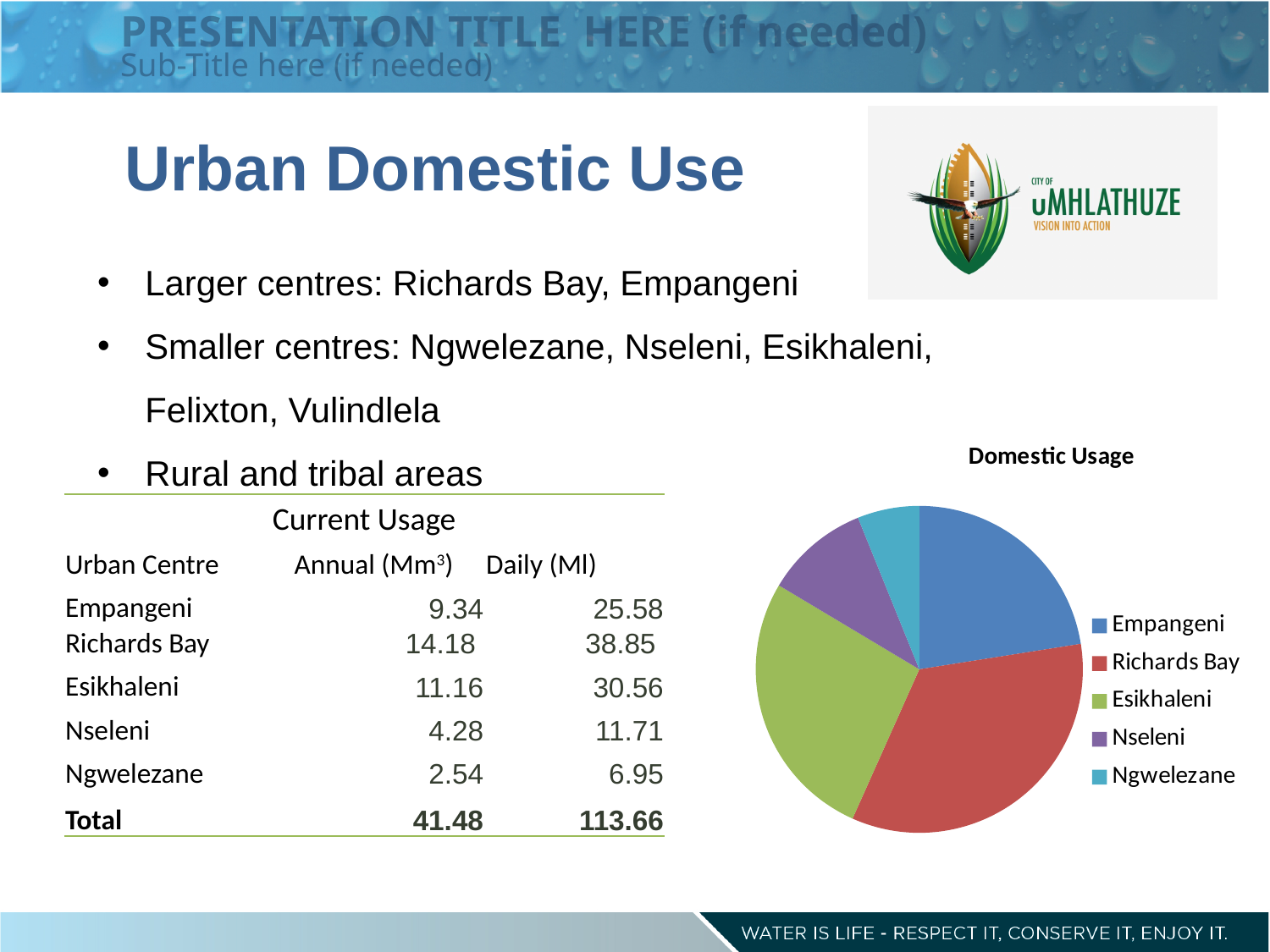
In the Domestic Usage pie chart, which slice is larger: Esikhaleni or Nseleni? Esikhaleni In the Domestic Usage pie chart, which slice is larger: Richards Bay or Empangeni? Richards Bay In the Domestic Usage pie chart, which slice is larger: Nseleni or Ngwelezane? Nseleni What kind of chart is the Domestic Usage chart? pie chart What is the title of the pie chart on the slide? Domestic Usage Which urban centre has the largest slice in the Domestic Usage pie chart? Richards Bay How many slices does the Domestic Usage pie chart have? 5 How many entries does the legend of the Domestic Usage chart list? 5 Which urban centre has the smallest slice in the Domestic Usage pie chart? Ngwelezane Which urban centre is shown in red in the Domestic Usage pie chart? Richards Bay